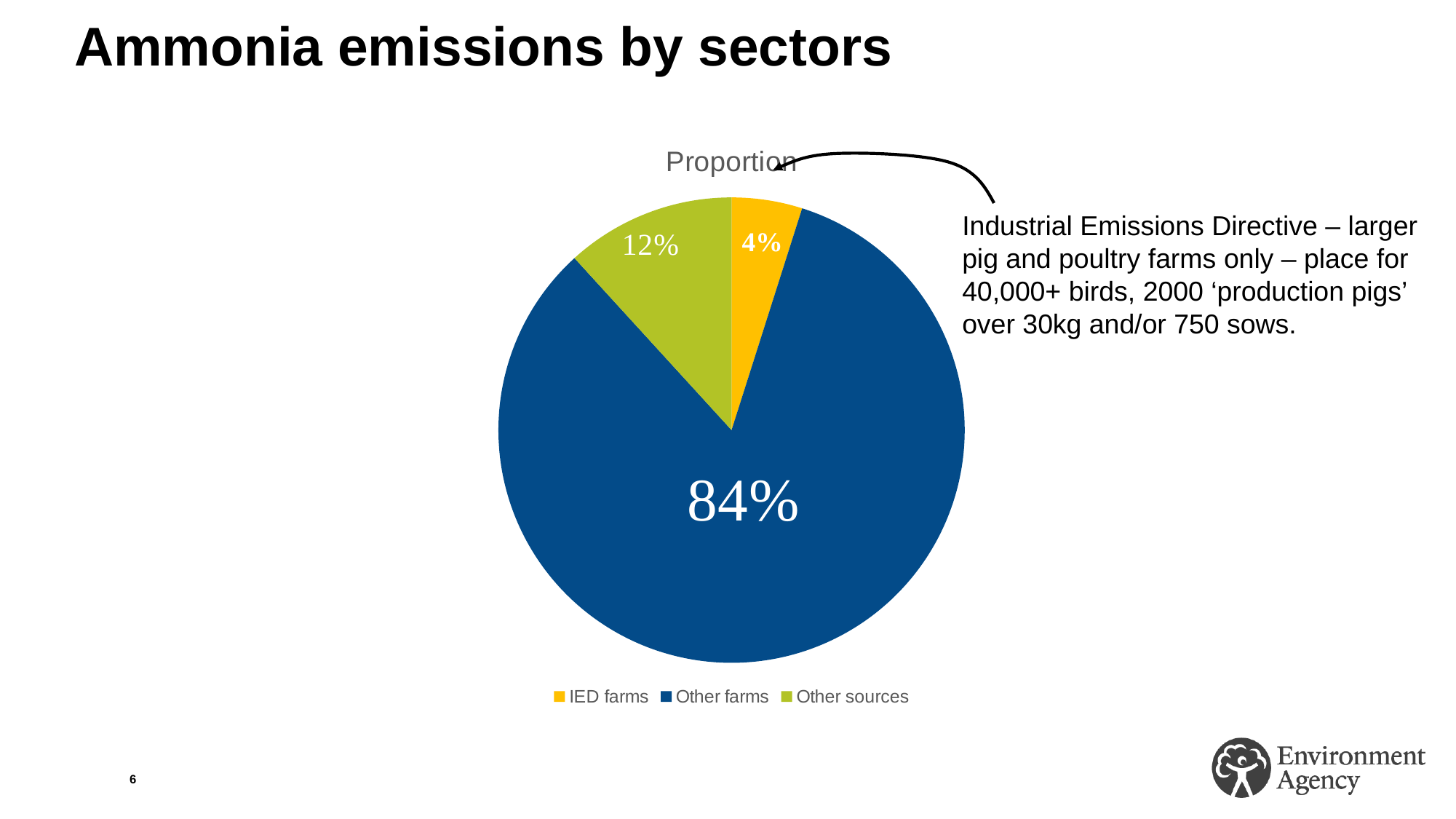
What is the title of the chart? Proportion What is the difference in percentage points between Other sources and IED farms? 8 What type of chart is shown on the slide? Pie chart What is the difference in percentage points between Other farms and Other sources? 72 What share of ammonia emissions comes from Other sources? 12% Which category has the largest share of the pie? Other farms What colour is the slice for IED farms? Yellow Which is larger, the share for Other sources or the share for IED farms? Other sources Which category has the smallest share of the pie? IED farms How many categories does the pie chart show? 3 What share of ammonia emissions comes from Other farms? 84% What share of ammonia emissions comes from IED farms? 4%